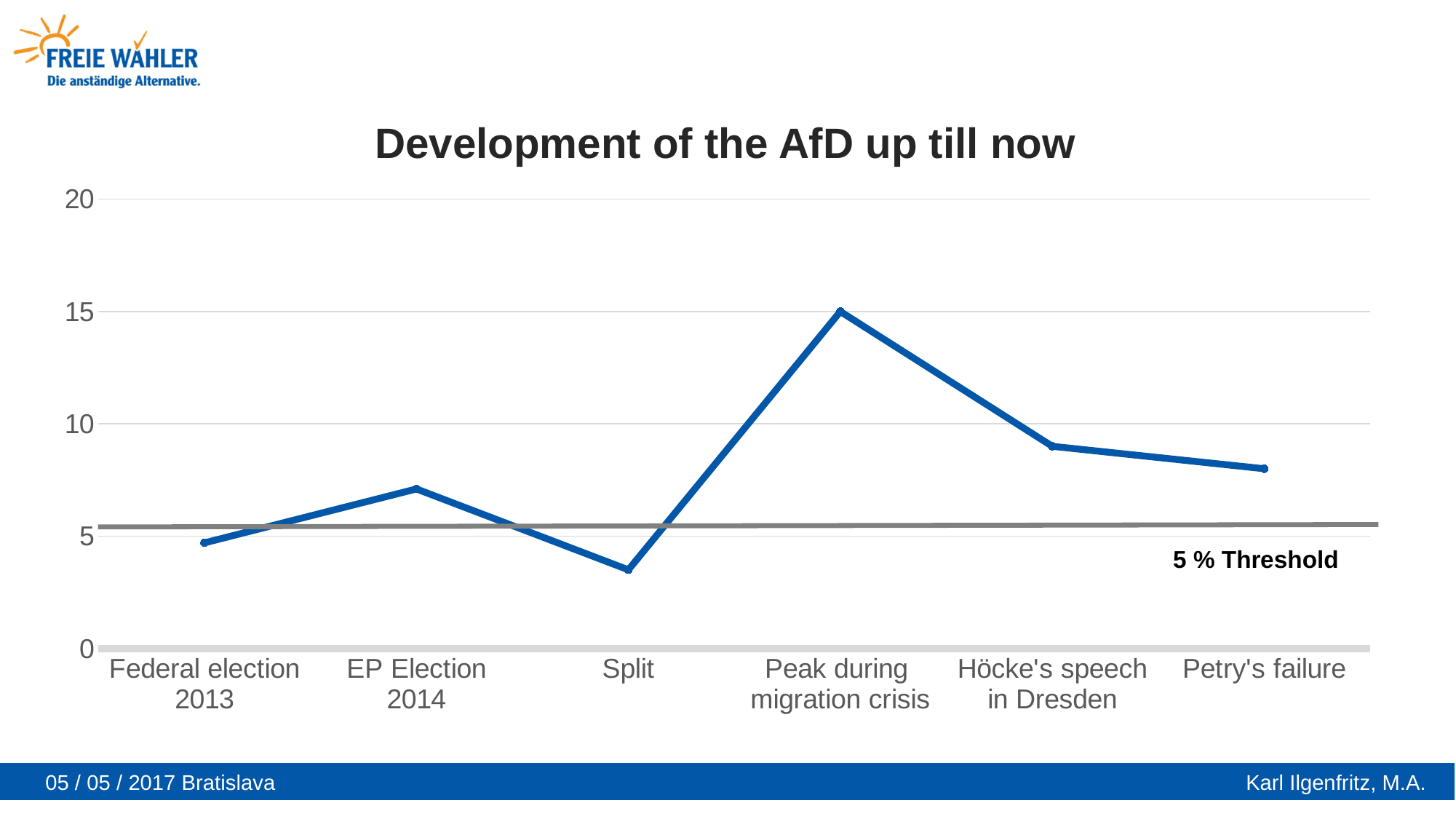
Is the value for Höcke's speech in Dresden greater or less than 10? less Is the value for EP Election 2014 greater or less than 5? greater How many categories are plotted along the x axis? 6 What type of chart is shown on the slide? line chart Do the values rise or fall from Peak during migration crisis to Petry's failure? fall Is the value for Federal election 2013 greater or less than 5? less What is the value for Peak during migration crisis? 15 Which category has the lowest value? Split Which category has the highest value? Peak during migration crisis What does the horizontal grey line on the chart represent? 5 % Threshold Which is larger, the value for Höcke's speech in Dresden or the value for Petry's failure? Höcke's speech in Dresden What is the title of the chart? Development of the AfD up till now